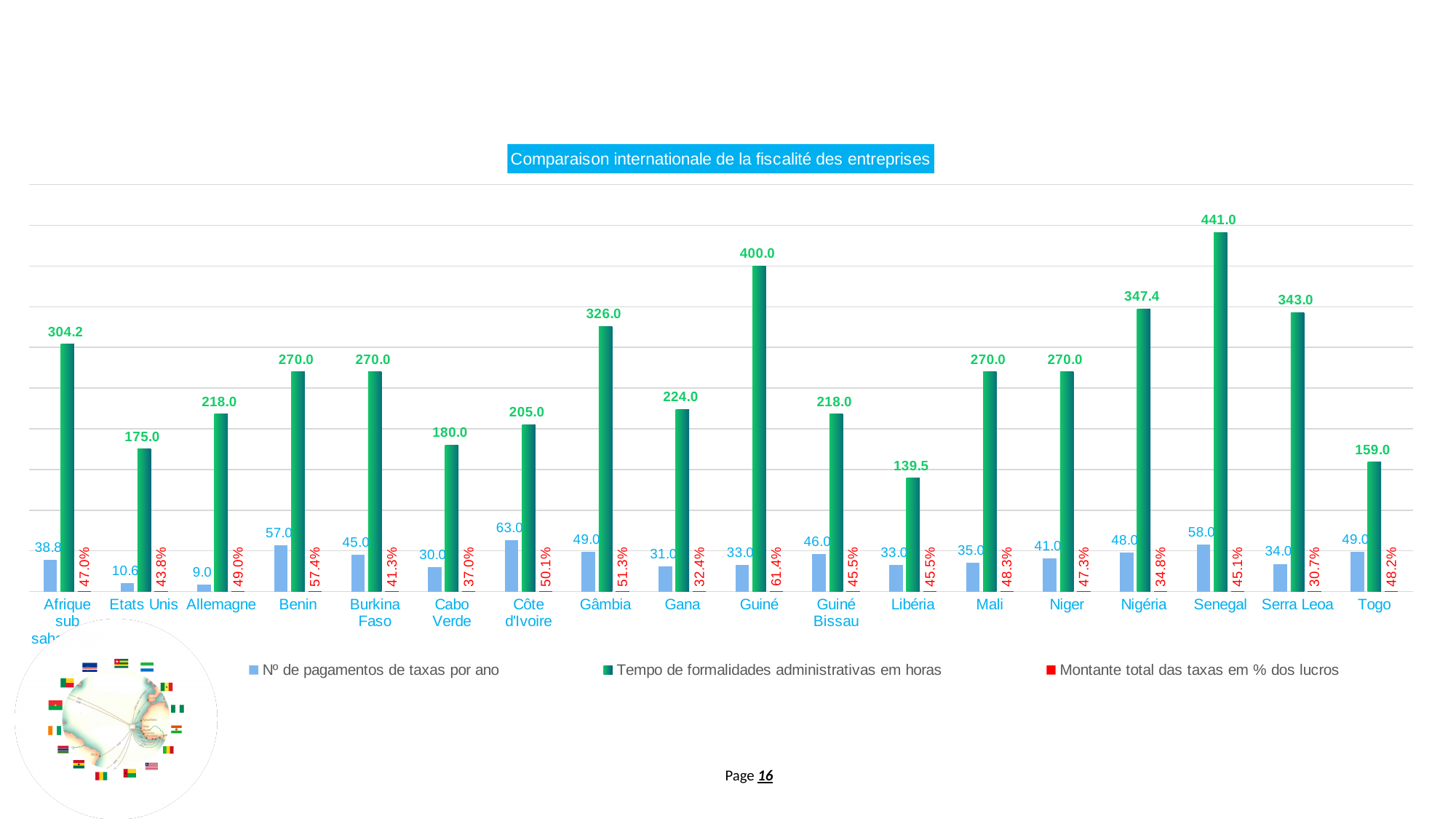
Which country has the highest value for 'Tempo de formalidades administrativas em horas'? Senegal Which is larger, the 'Tempo de formalidades administrativas em horas' value for Nigéria or for Serra Leoa? Nigéria What is the value of 'Montante total das taxas em % dos lucros' for Guiné? 61.4% What is the difference between the 'Nº de pagamentos de taxas por ano' values for Benin and Allemagne? 48.0 What is the value of 'Tempo de formalidades administrativas em horas' for Senegal? 441.0 How many series does the legend list? 3 What is the value of 'Nº de pagamentos de taxas por ano' for Côte d'Ivoire? 63.0 What is the value of 'Montante total das taxas em % dos lucros' for Serra Leoa? 30.7% What kind of chart is shown on the slide? Bar chart Which country has the lowest value for 'Tempo de formalidades administrativas em horas'? Libéria What is the title of the chart? Comparaison internationale de la fiscalité des entreprises What is the difference between the 'Tempo de formalidades administrativas em horas' values for Guiné and Gâmbia? 74.0